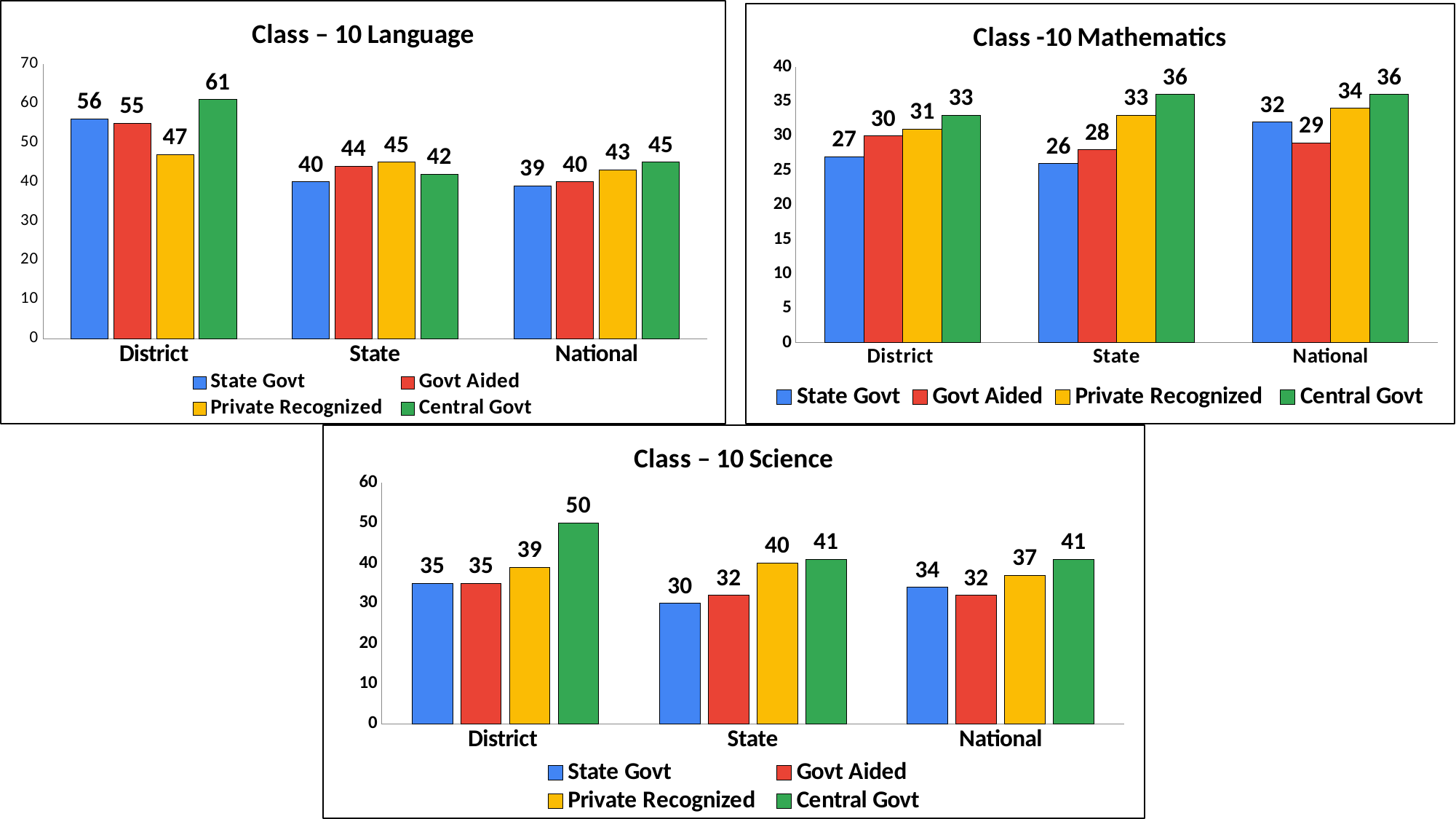
In the Class – 10 Science chart, what is the value for Private Recognized in the State category? 40 In the Class – 10 Language chart, which is larger in the National category: State Govt or Central Govt? Central Govt What kind of chart is the Class – 10 Language chart? Bar chart In the Class – 10 Science chart, how many categories are shown on the x axis? 3 In the Class -10 Mathematics chart, what is the value for Govt Aided in the National category? 29 In the Class -10 Mathematics chart, which series has the lowest value in the State category? State Govt In the Class – 10 Science chart, which colour represents Central Govt in the legend? Green In the Class – 10 Language chart, which series has the highest value in the State category? Private Recognized In the Class – 10 Science chart, what is the difference between Central Govt and State Govt in the District category? 15 In the Class – 10 Language chart, what is the value for Central Govt in the District category? 61 In the Class -10 Mathematics chart, what is the difference between Central Govt and Govt Aided in the District category? 3 In the Class -10 Mathematics chart, how many series does the legend list? 4